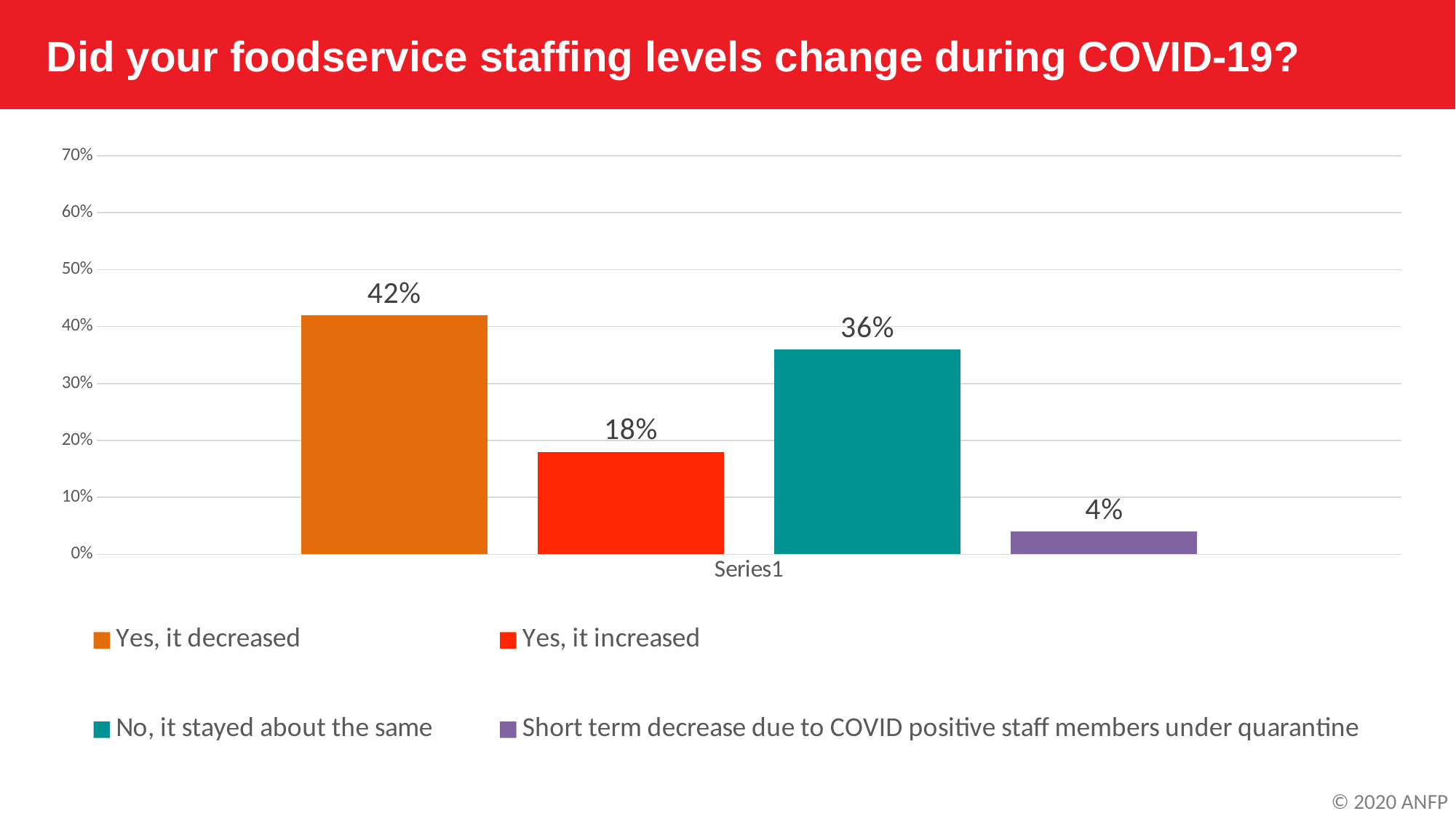
What percentage of respondents said their foodservice staffing levels decreased during COVID-19? 42% What is the difference in percentage points between 'Yes, it increased' and 'Short term decrease due to COVID positive staff members under quarantine'? 14 percentage points Which response has the lowest percentage? Short term decrease due to COVID positive staff members under quarantine What type of chart is shown on the slide? Bar chart How many response categories are shown in the chart? 4 What is the difference in percentage points between 'Yes, it decreased' and 'No, it stayed about the same'? 6 percentage points What colour is the bar for 'No, it stayed about the same'? Teal What percentage of respondents said their foodservice staffing levels increased? 18% What percentage of respondents said staffing levels stayed about the same? 36% Which response has the highest percentage? Yes, it decreased Which is larger: the percentage for 'Yes, it increased' or for 'No, it stayed about the same'? No, it stayed about the same What percentage of respondents reported a short term decrease due to COVID positive staff members under quarantine? 4%